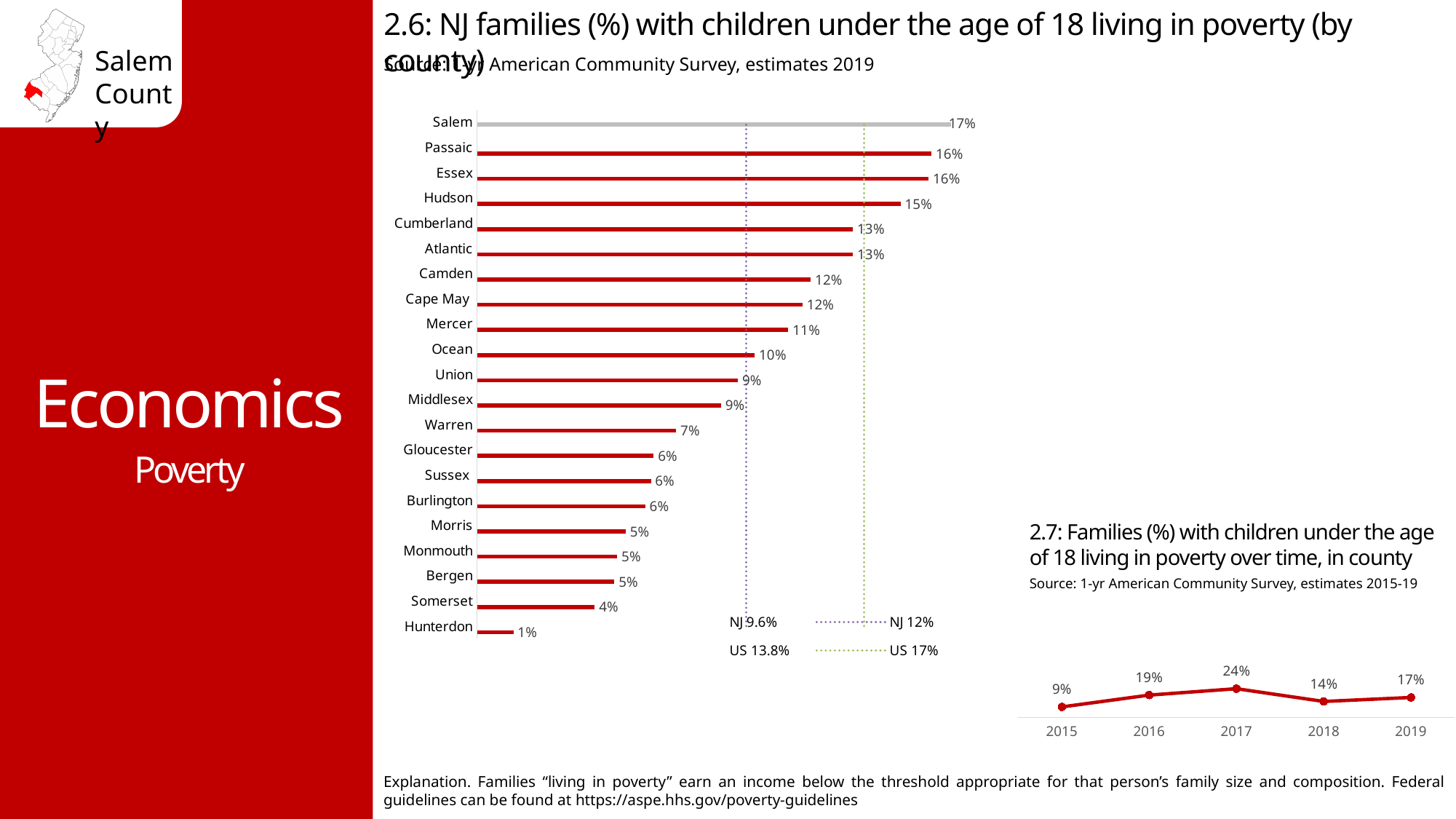
What kind of chart is chart 2.6 (by county)? Bar chart In chart 2.6 (by county), what is the value for Hudson? 15% In chart 2.6 (by county), which is larger, the value for Camden or the value for Warren? Camden In chart 2.6 (NJ families with children under 18 living in poverty by county), what is the value for Salem? 17% In chart 2.7 (families in poverty over time, in county), what is the value for 2017? 24% In chart 2.7 (over time, in county), which year has the lowest value? 2015 What kind of chart is chart 2.7 (over time, in county)? Line chart In chart 2.6 (by county), which county has the lowest value? Hunterdon In chart 2.6 (by county), how many counties are shown? 21 In chart 2.6 (by county), which county has the highest value? Salem In chart 2.6 (by county), what is the difference between Salem and Hunterdon? 16% In chart 2.7 (over time, in county), what is the difference between 2017 and 2018? 10%